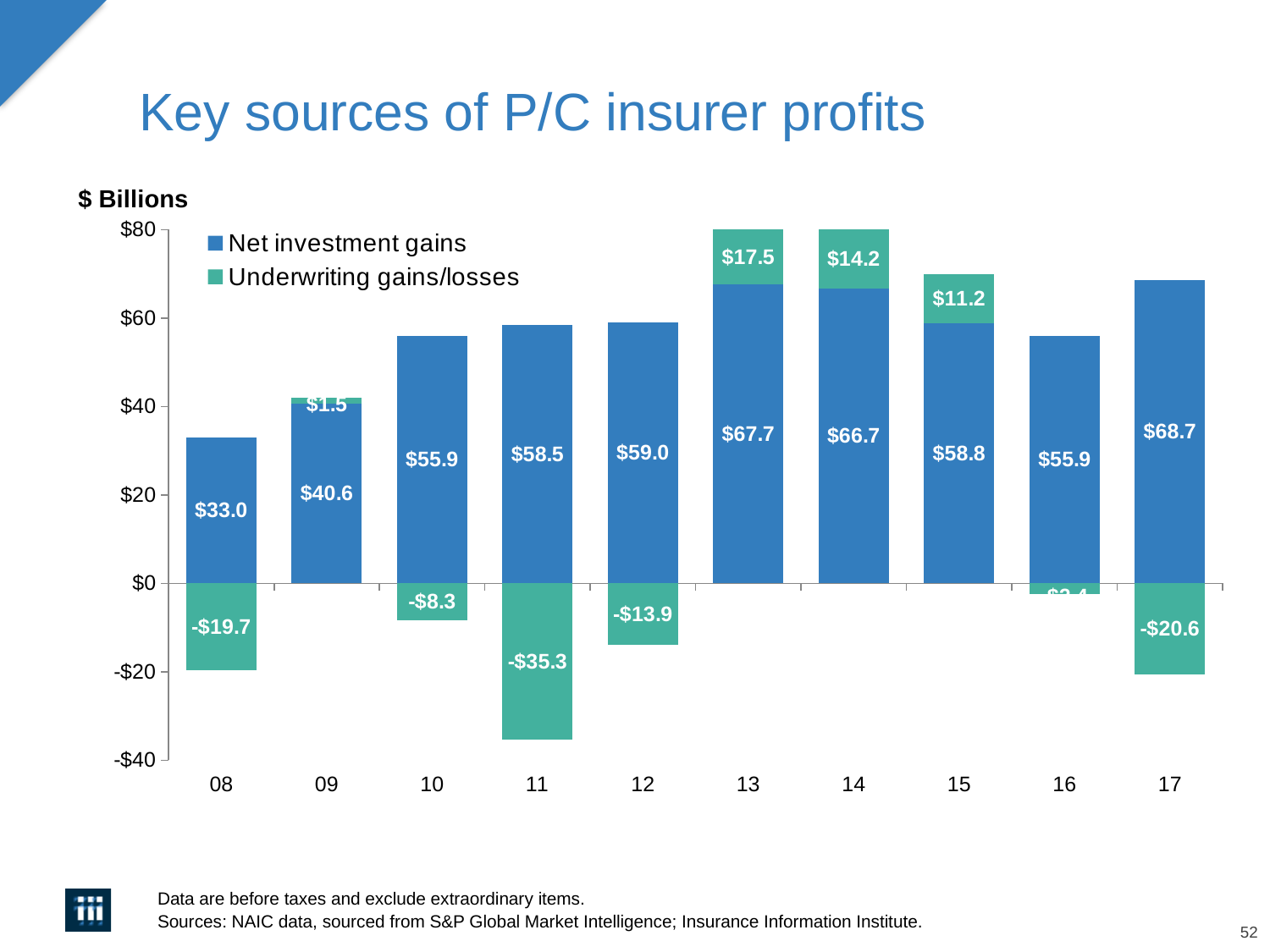
What kind of chart is shown on the slide? Stacked bar chart Which year has the highest Underwriting gains/losses? 13 How many series does the legend list? 2 How many years are shown on the x axis? 10 What is the value of Underwriting gains/losses for 15? $11.2 What is the value of Net investment gains for 13? $67.7 Which year has the highest Net investment gains? 17 What is the value of Underwriting gains/losses for 11? -$35.3 Which year has the lowest Net investment gains? 08 Which year has larger Underwriting gains/losses, 13 or 14? 13 Which year has the lowest Underwriting gains/losses? 11 What is the difference between Net investment gains in 17 and in 08? $35.7